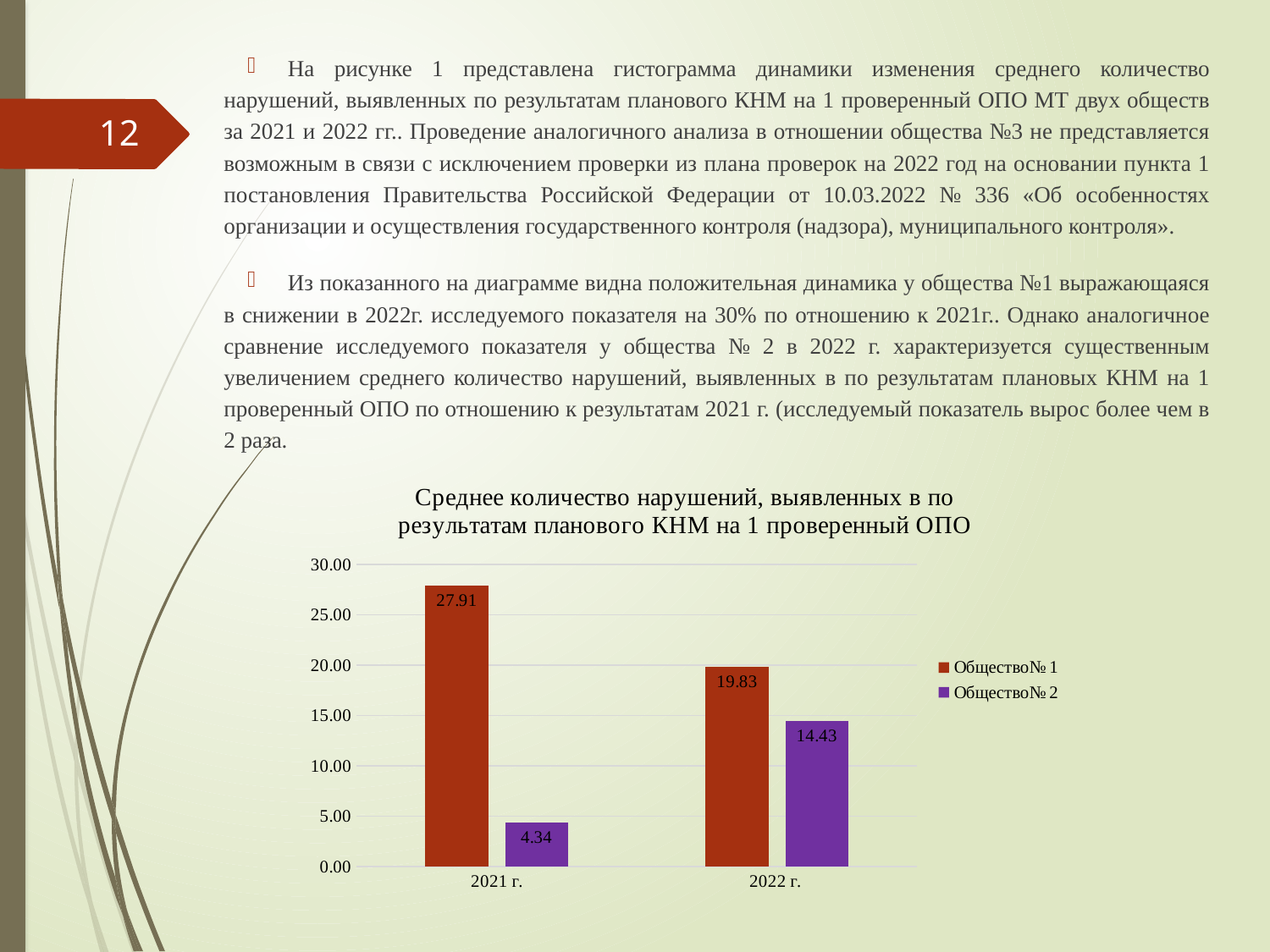
What is the difference between the values for Общество№1 in 2021 г. and 2022 г.? 8.08 What is the value for Общество№1 in 2021 г.? 27.91 What is the value for Общество№2 in 2022 г.? 14.43 Does the value for Общество№1 rise or fall from 2021 г. to 2022 г.? Fall What is the value for Общество№1 in 2022 г.? 19.83 Which bar on the chart has the lowest value? Общество№2 in 2021 г. What is the difference between the values for Общество№1 and Общество№2 in 2022 г.? 5.40 Which is larger: Общество№2 in 2021 г. or Общество№2 in 2022 г.? Общество№2 in 2022 г. How many series does the legend list? 2 What is the value for Общество№2 in 2021 г.? 4.34 Which series has the highest value in 2021 г.? Общество№1 What kind of chart is shown on the slide? Bar chart